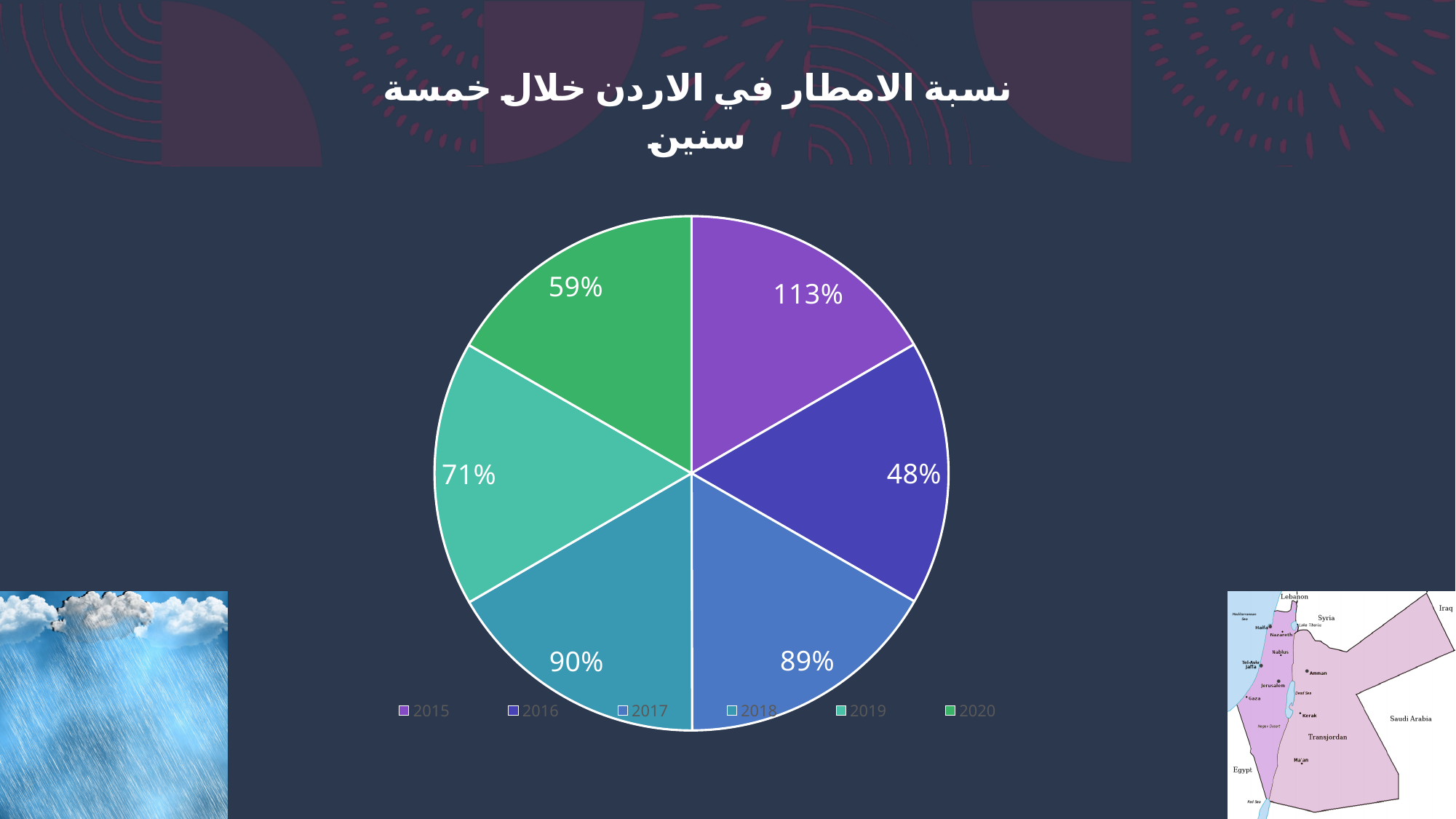
Which year has the highest labelled value? 2015 How many entries does the legend list? 6 What value is shown for 2020? 59% What value is shown for 2016? 48% What type of chart is shown on the slide? pie chart What value is shown for 2018? 90% What colour is the slice for 2020? green Which is larger, the value for 2019 or the value for 2020? 2019 What is the difference between the values for 2015 and 2016? 65% What value is shown for 2015? 113% How many slices does the pie chart have? 6 Which year has the lowest labelled value? 2016